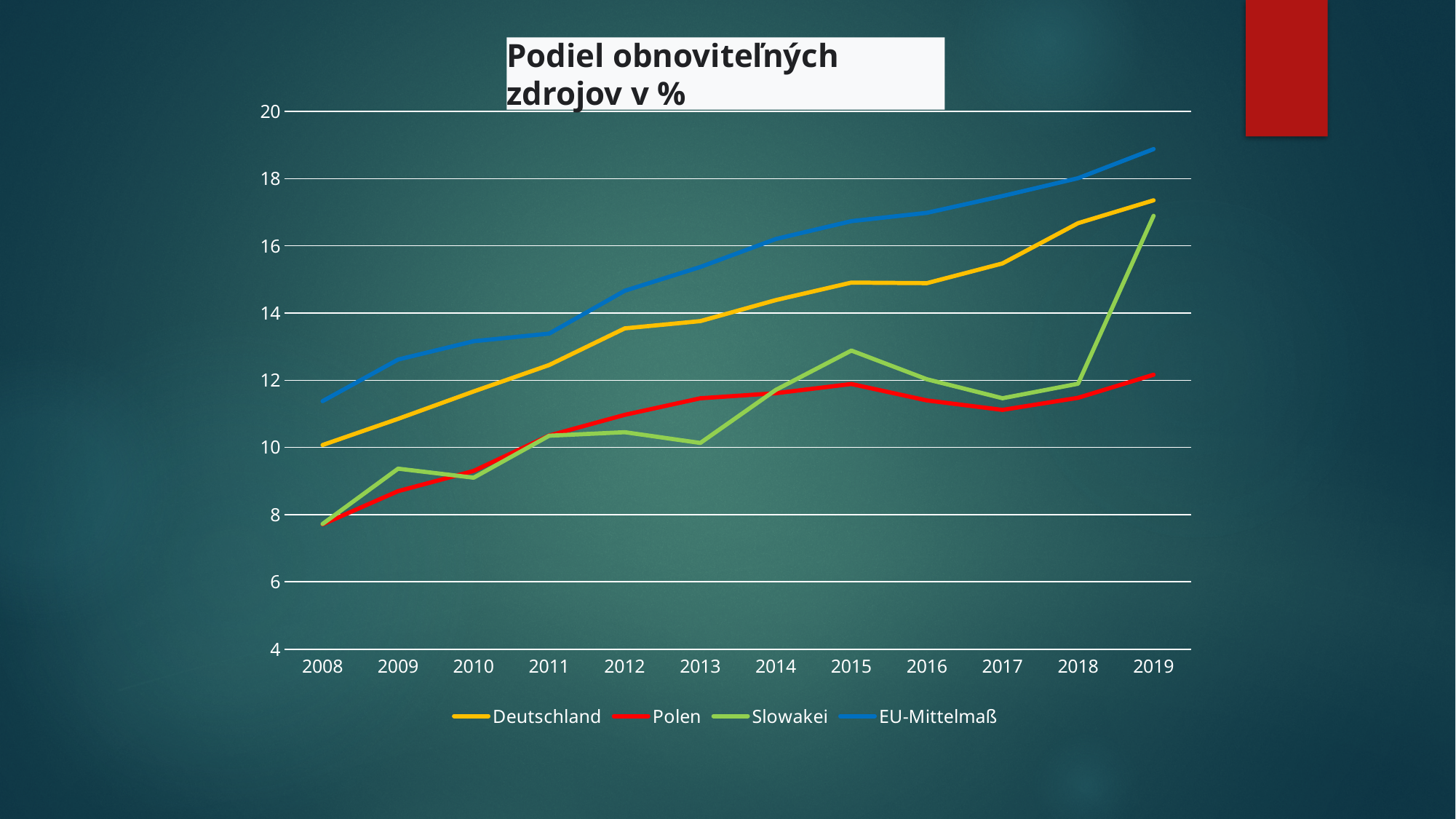
In which year does Slowakei reach its highest value? 2019 How many series does the legend list? 4 Which is larger in 2015, the value for Slowakei or the value for Polen? Slowakei Which series has the lowest value in 2019? Polen What kind of chart is shown on the slide? line chart How many years are shown on the x axis? 12 Is the value for EU-Mittelmaß in 2019 greater or less than 18? greater Is the value for Polen in 2008 greater or less than 8? less Does the EU-Mittelmaß line rise or fall from 2008 to 2019? rise What is the title of the chart? Podiel obnoviteľných zdrojov v % Is the value for Deutschland in 2012 greater or less than 14? less Which series has the highest value in 2019? EU-Mittelmaß